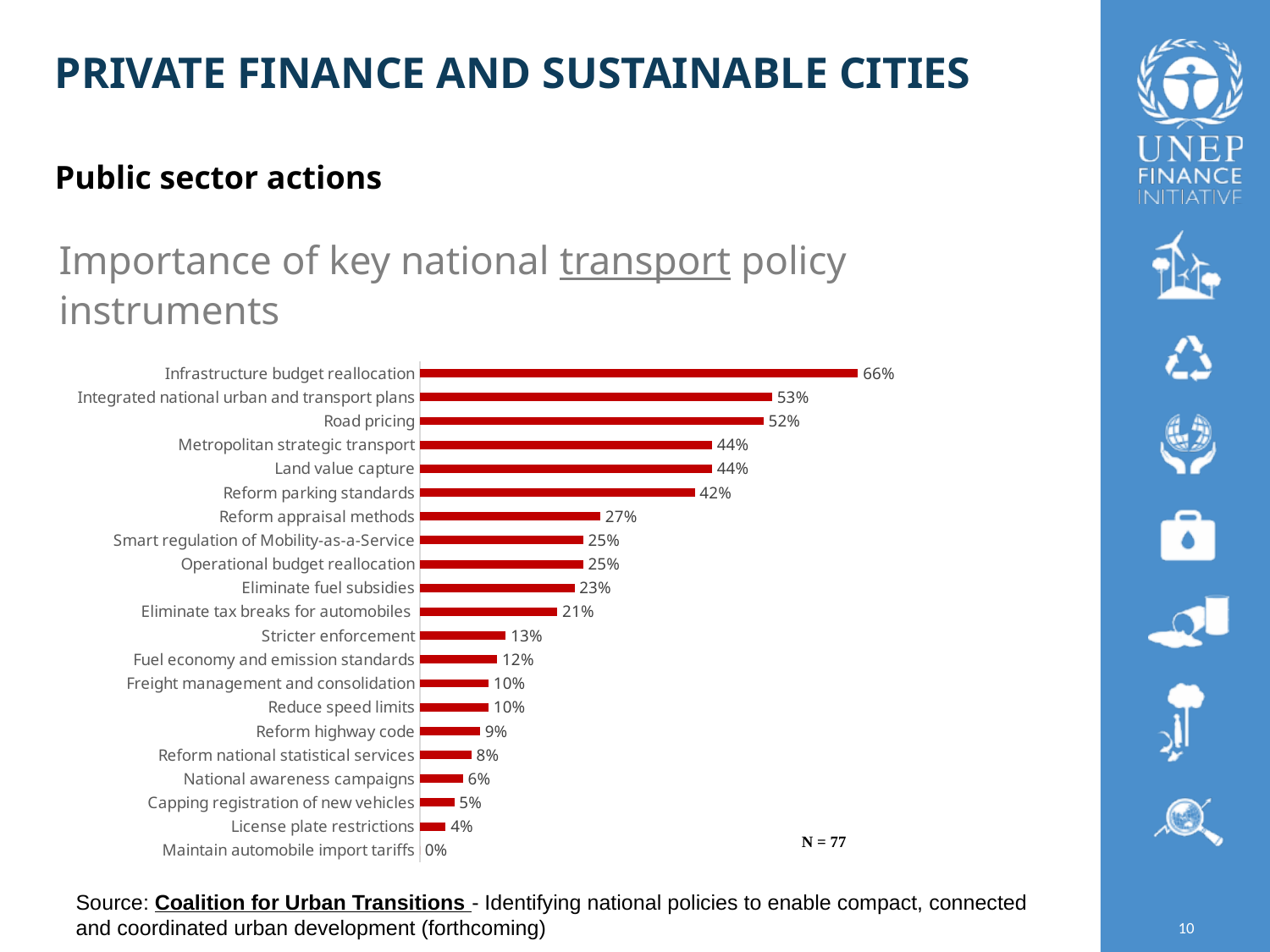
What sample size (N) is shown on the chart? N = 77 Which policy instrument has the lowest value? Maintain automobile import tariffs How many policy instruments are shown in the chart? 21 What is the difference between Stricter enforcement and Fuel economy and emission standards? 1% What is the difference between Infrastructure budget reallocation and Integrated national urban and transport plans? 13% What is the value for License plate restrictions? 4% Which policy instrument has the highest value? Infrastructure budget reallocation What is the value for Infrastructure budget reallocation? 66% What kind of chart is shown on the slide? Bar chart Which is larger, Reform parking standards or Reform appraisal methods? Reform parking standards What is the value for Road pricing? 52% What is the value for Eliminate fuel subsidies? 23%